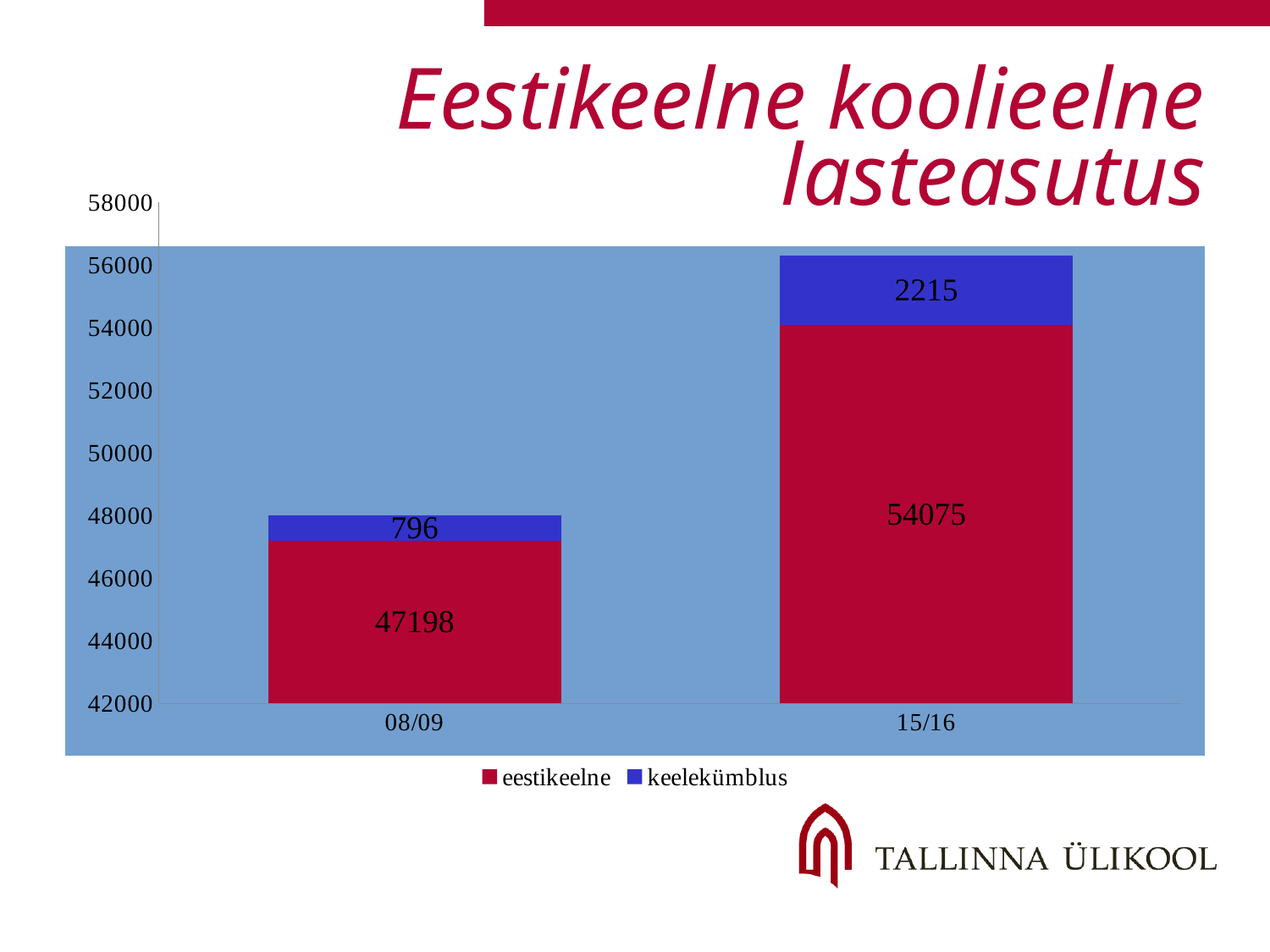
What is the difference between the eestikeelne values for 15/16 and 08/09? 6877 What is the total of the stacked bar for 15/16? 56290 Which year has the higher eestikeelne value, 08/09 or 15/16? 15/16 Which colour represents keelekümblus in the chart? Blue What is the value for keelekümblus in 08/09? 796 What kind of chart is shown on the slide? Stacked bar chart What is the total of the stacked bar for 08/09? 47994 What is the value for keelekümblus in 15/16? 2215 What is the difference between the keelekümblus values for 15/16 and 08/09? 1419 What is the value for eestikeelne in 08/09? 47198 How many series does the legend list? 2 What is the value for eestikeelne in 15/16? 54075